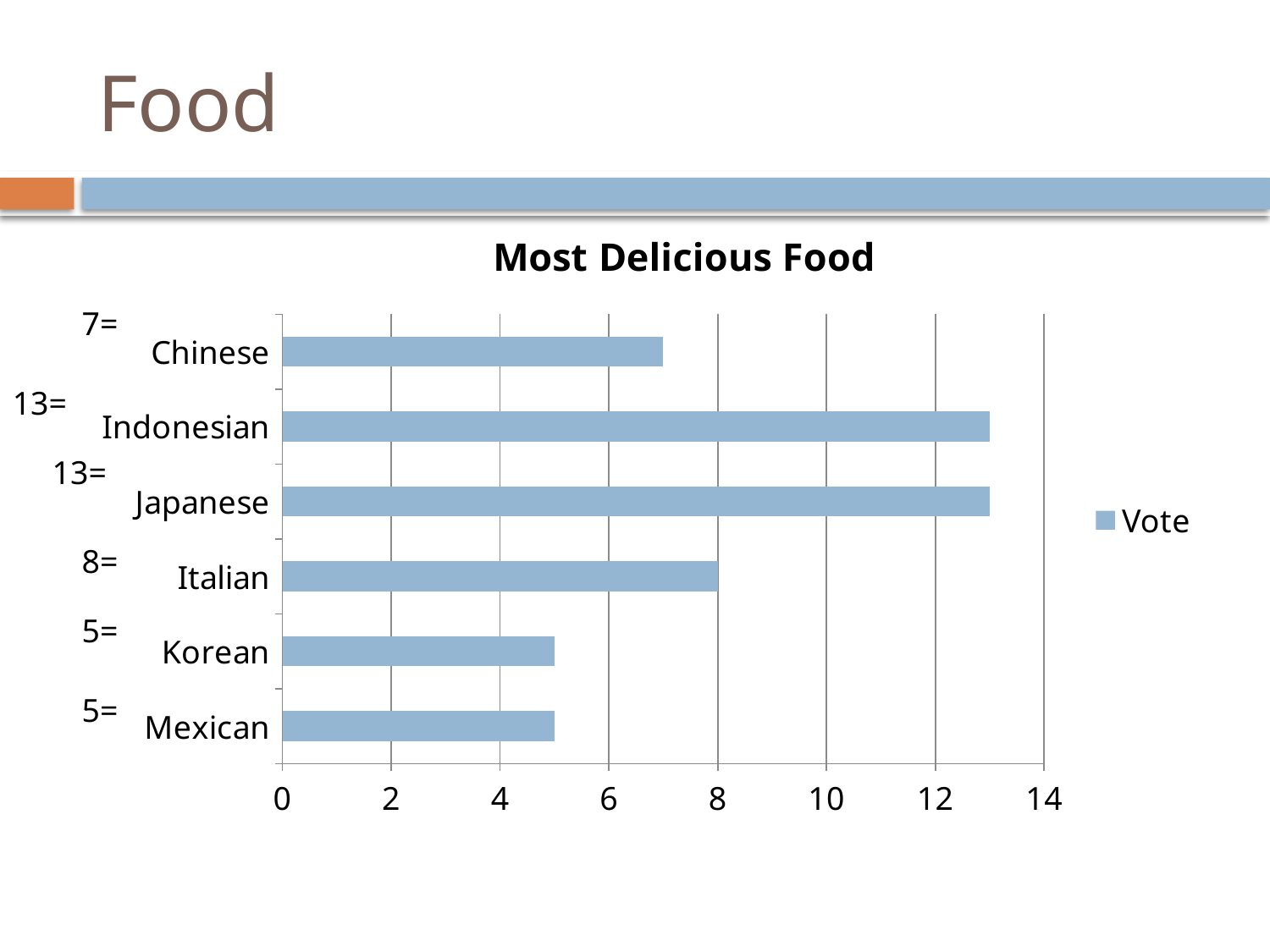
What is the difference in votes between Japanese and Mexican food? 8 What kind of chart is shown on the slide? Bar chart Is the value for Indonesian greater or less than 12? greater How many votes did Indonesian food receive? 13 How many votes did Korean food receive? 5 How many food categories are shown in the chart? 6 What is the name of the series shown in the legend? Vote How many votes did Italian food receive? 8 Which received more votes, Italian or Chinese food? Italian What is the title of the chart? Most Delicious Food How many votes did Chinese food receive? 7 How many series does the legend list? 1